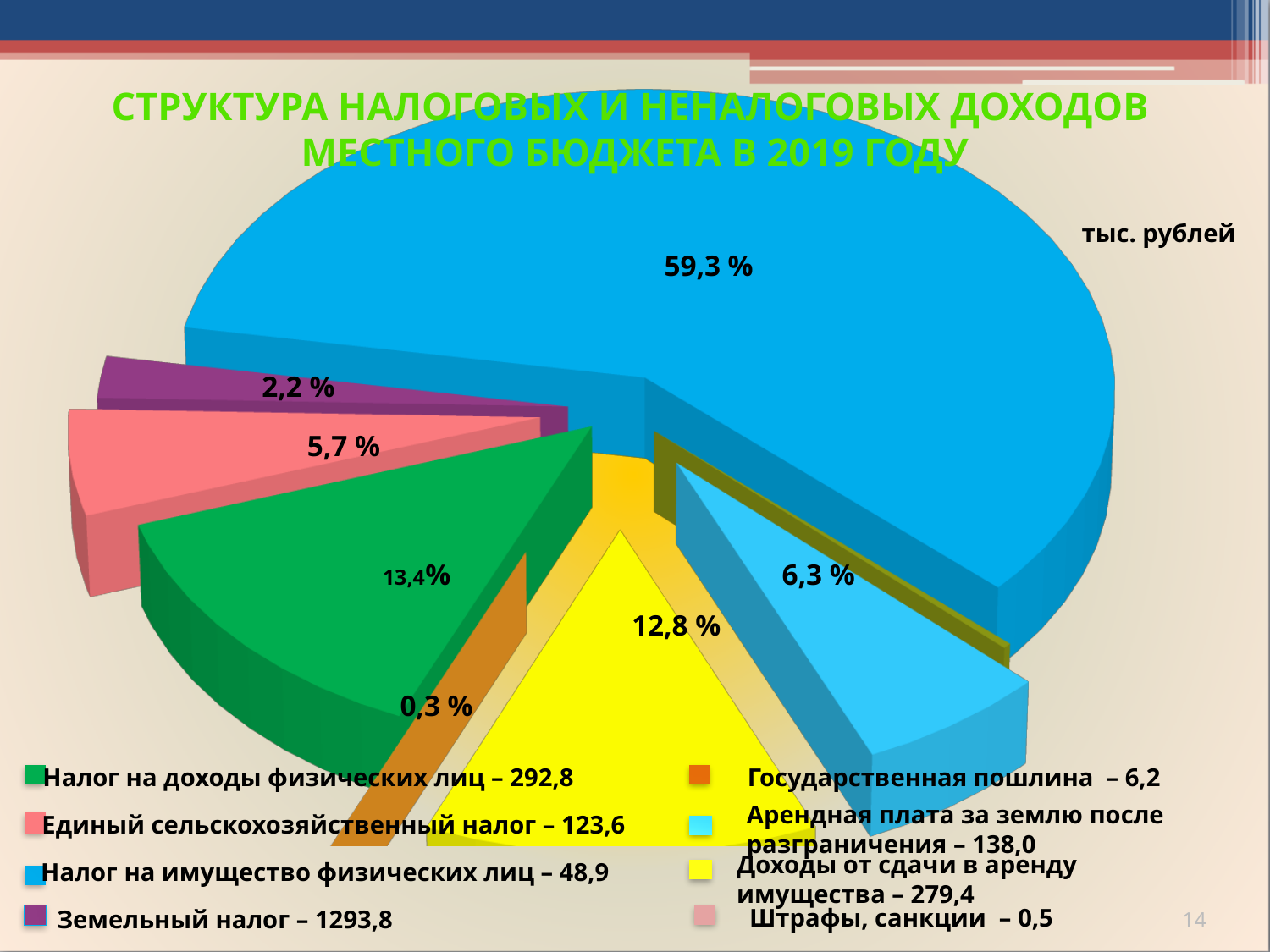
Which legend category has the largest value? Земельный налог What is the difference between the legend values for Налог на доходы физических лиц and Единый сельскохозяйственный налог? 169,2 What is the value shown in the legend for Арендная плата за землю после разграничения? 138,0 What is the value shown in the legend for Земельный налог? 1293,8 What is the value shown in the legend for Налог на доходы физических лиц? 292,8 What kind of chart is shown on the slide? pie chart How many categories does the legend list? 8 Which legend category has the smallest value? Штрафы, санкции What is the largest percentage label shown on the pie chart? 59,3 % What unit is indicated for the values on the slide? тыс. рублей Which is larger: the value for Единый сельскохозяйственный налог or the value for Доходы от сдачи в аренду имущества? Доходы от сдачи в аренду имущества What is the value shown in the legend for Штрафы, санкции? 0,5